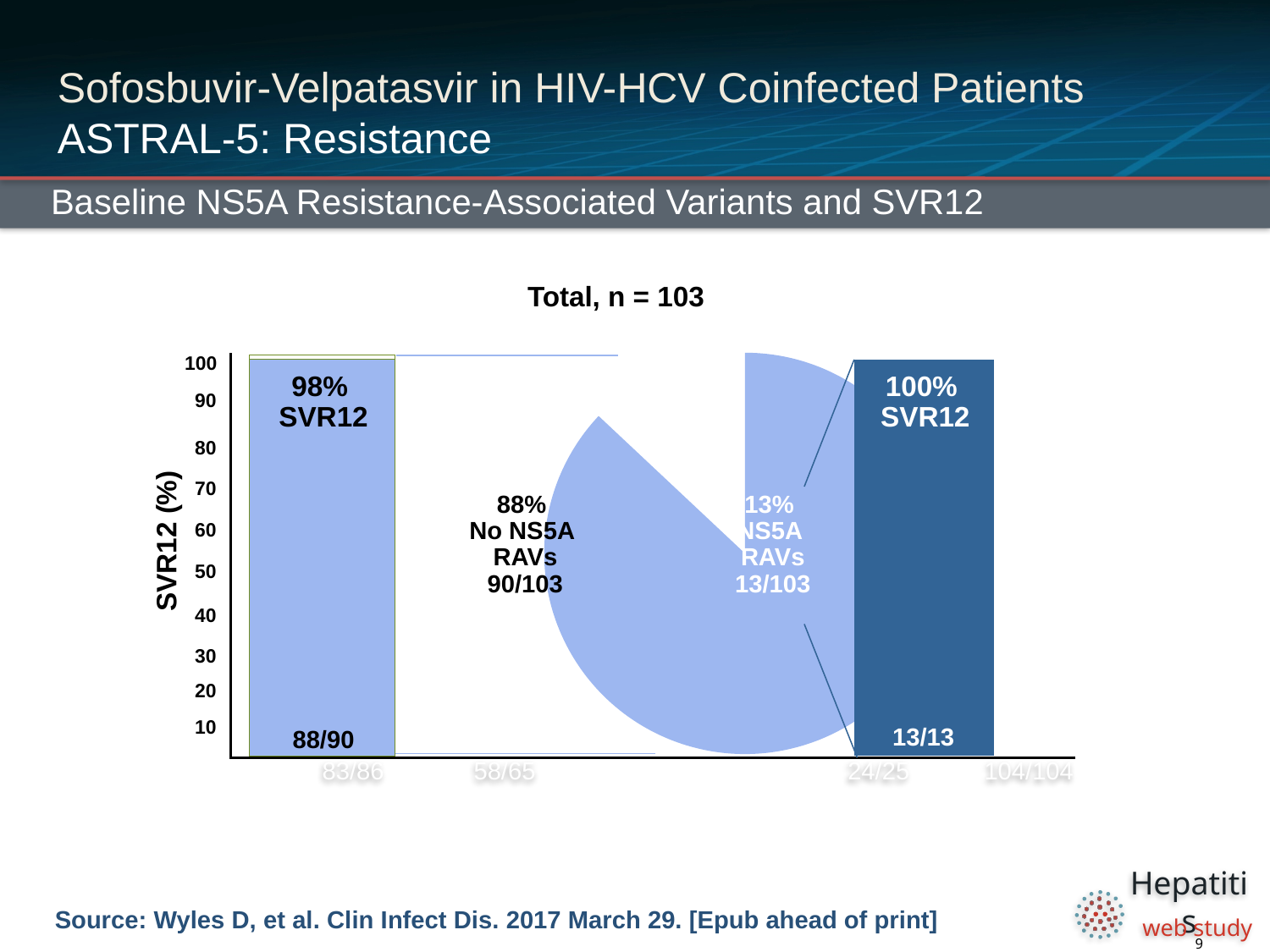
In the pie chart, how many of the 103 patients had no NS5A RAVs? 90/103 What is the SVR12 rate for patients with no NS5A RAVs (left bar)? 98% In the pie chart, what share of patients had NS5A RAVs? 13% In the pie chart, how many of the 103 patients had NS5A RAVs? 13/103 What is the label on the y axis of the bar chart? SVR12 (%) In the pie chart, what share of patients had no NS5A RAVs? 88% What is the total number of patients shown above the chart? 103 How many patients achieved SVR12 among those with NS5A RAVs, as shown on the right bar? 13/13 What is the difference in SVR12 rate between the NS5A RAVs group and the no NS5A RAVs group? 2% How many patients achieved SVR12 among those with no NS5A RAVs, as shown on the left bar? 88/90 What is the SVR12 rate for patients with NS5A RAVs (right bar)? 100% Which group has the higher SVR12 rate: patients with NS5A RAVs or patients with no NS5A RAVs? NS5A RAVs